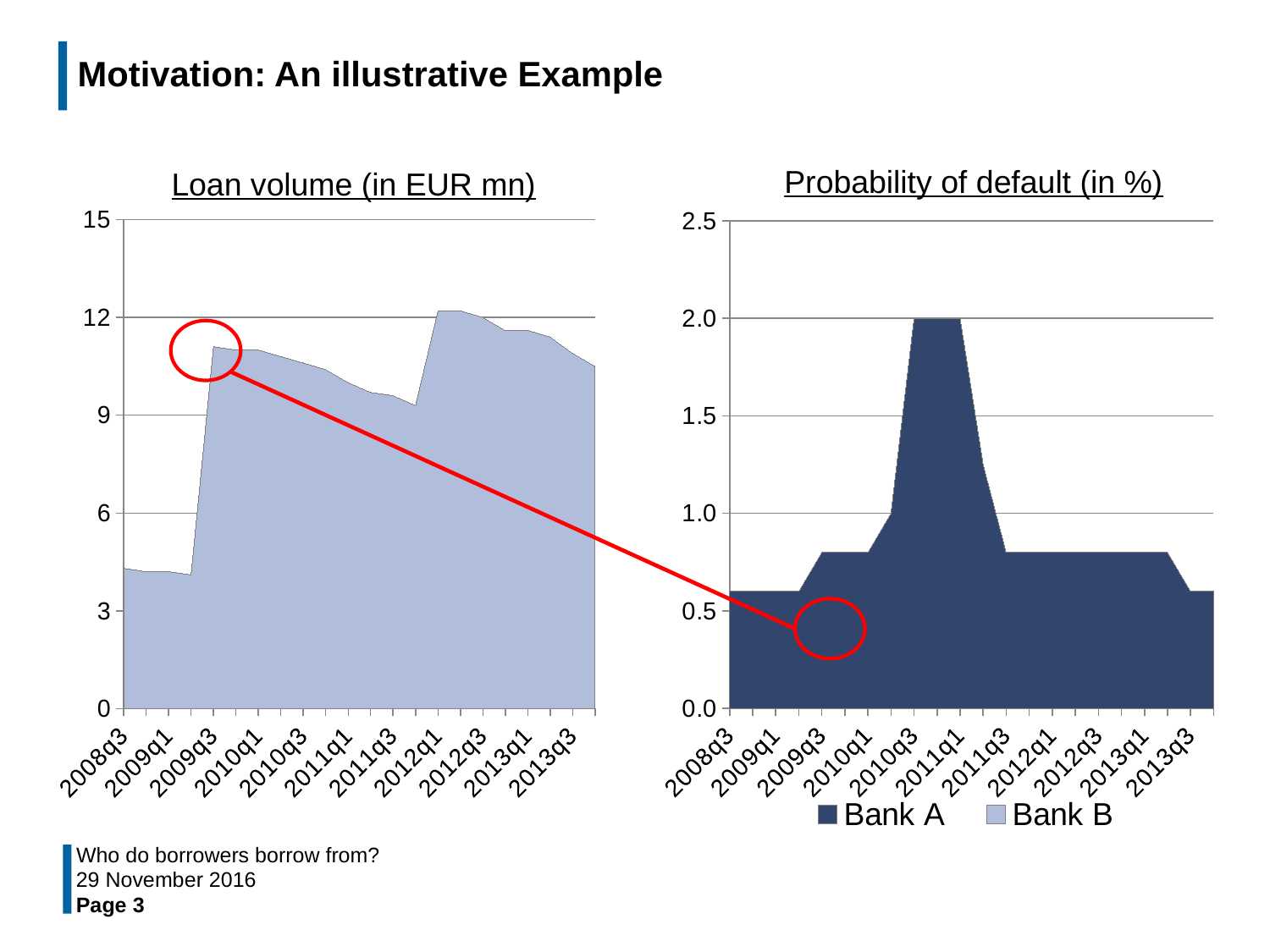
In the 'Loan volume (in EUR mn)' chart, is the value for 2009q3 greater or less than 9? greater In the 'Loan volume (in EUR mn)' chart, which is larger, the value at 2008q3 or the value at 2009q3? 2009q3 In the 'Probability of default (in %)' chart, which is larger, the value at 2011q1 or the value at 2012q1? 2011q1 In the 'Probability of default (in %)' chart, is the value for 2011q1 greater or less than 1.5? greater Which series is shown in the dark blue colour in the legend? Bank A In the 'Probability of default (in %)' chart, is the value for 2012q1 greater or less than 1.0? less What kind of chart is the 'Loan volume (in EUR mn)' chart? area chart How many series does the legend list? 2 In the 'Loan volume (in EUR mn)' chart, do the values rise or fall from 2009q3 to 2011q3? fall In the 'Probability of default (in %)' chart, what is the value at 2011q1? 2.0